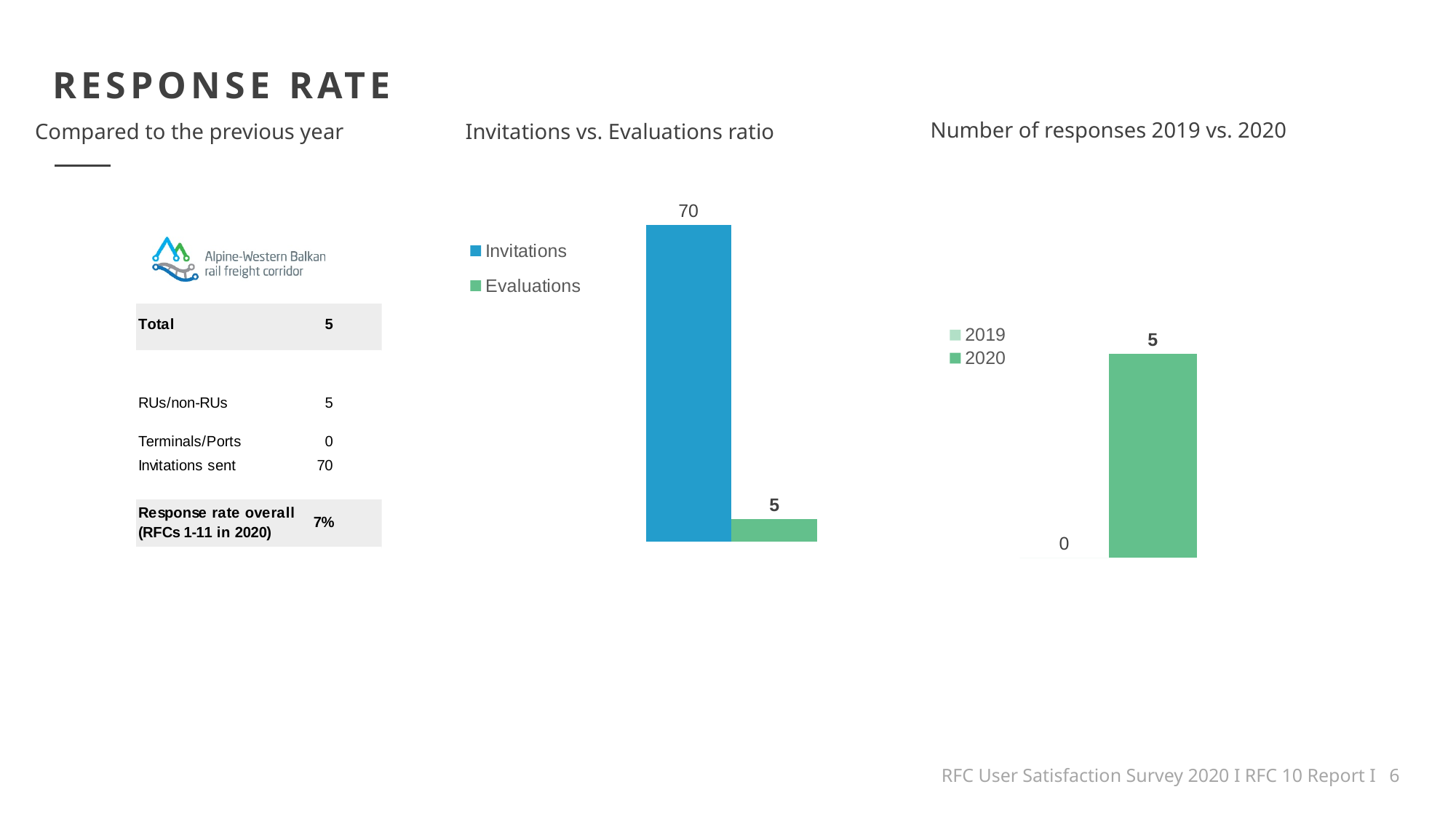
In the 'Invitations vs. Evaluations ratio' chart, what is the value for Invitations? 70 In the 'Invitations vs. Evaluations ratio' chart, which series has the higher value? Invitations In the 'Number of responses 2019 vs. 2020' chart, what is the difference between 2020 and 2019? 5 In the 'Invitations vs. Evaluations ratio' chart, what is the value for Evaluations? 5 In the 'Invitations vs. Evaluations ratio' chart, what colour is the Invitations bar? Blue In the 'Invitations vs. Evaluations ratio' chart, what is the difference between Invitations and Evaluations? 65 In the 'Invitations vs. Evaluations ratio' chart, how many series does the legend list? 2 In the 'Number of responses 2019 vs. 2020' chart, what is the value for 2019? 0 In the 'Number of responses 2019 vs. 2020' chart, what is the value for 2020? 5 In the 'Number of responses 2019 vs. 2020' chart, which year has the lower value? 2019 What kind of chart is the 'Invitations vs. Evaluations ratio' chart? Bar chart In the 'Number of responses 2019 vs. 2020' chart, how many series does the legend list? 2